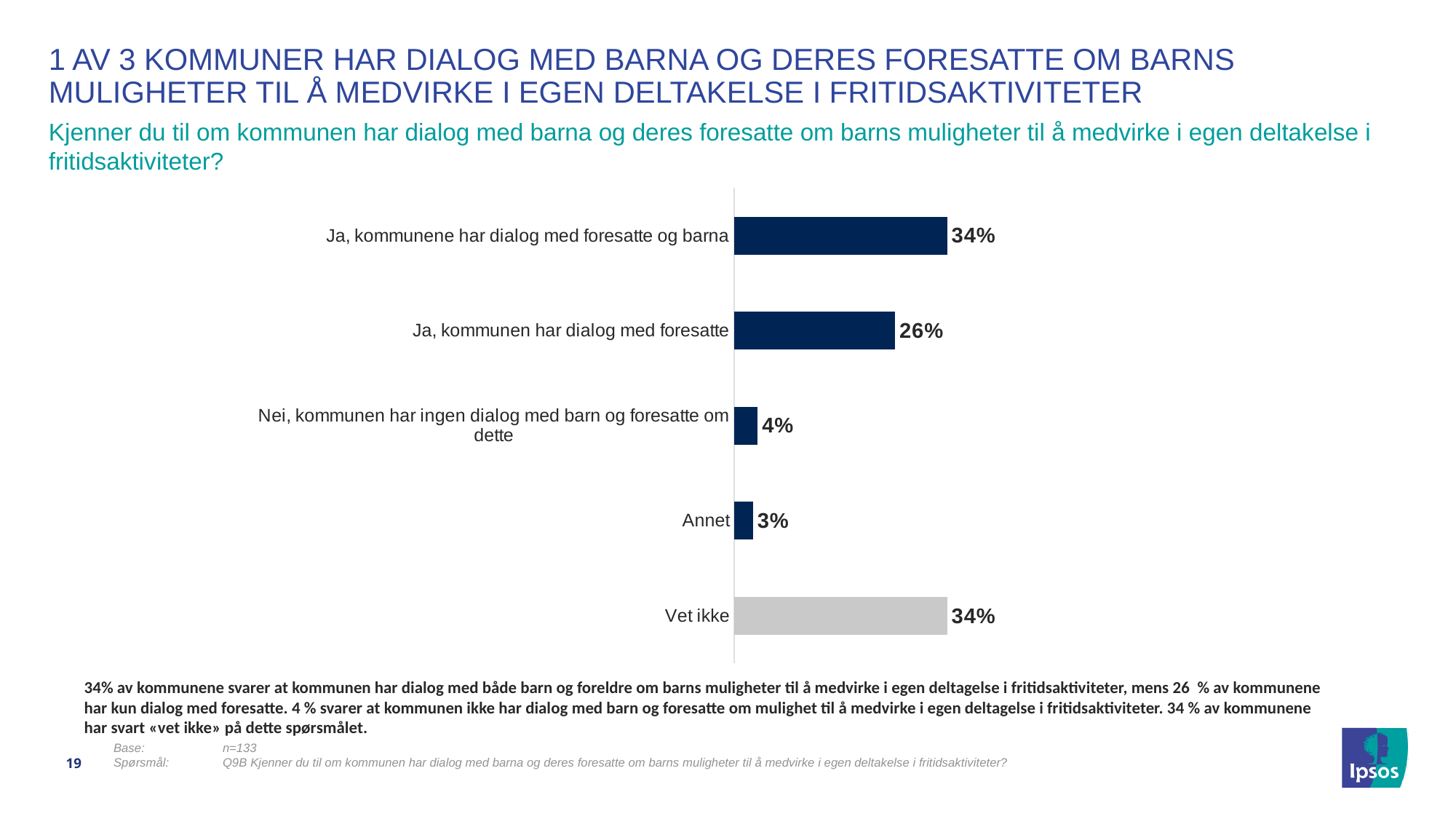
Which category has the lowest value? Annet What is the difference between "Vet ikke" and "Annet"? 31 percentage points What is the value for "Ja, kommunen har dialog med foresatte"? 26% What percentage answered "Annet"? 3% Which bar is shown in a different colour (grey) from the others? Vet ikke What kind of chart is shown on the slide? Bar chart How many categories are shown in the chart? 5 What is the value for "Nei, kommunen har ingen dialog med barn og foresatte om dette"? 4% What is the difference between "Ja, kommunene har dialog med foresatte og barna" and "Ja, kommunen har dialog med foresatte"? 8 percentage points What is the value for "Vet ikke"? 34% What percentage of municipalities answered "Ja, kommunene har dialog med foresatte og barna"? 34% Which is larger: the value for "Nei, kommunen har ingen dialog med barn og foresatte om dette" or the value for "Annet"? Nei, kommunen har ingen dialog med barn og foresatte om dette